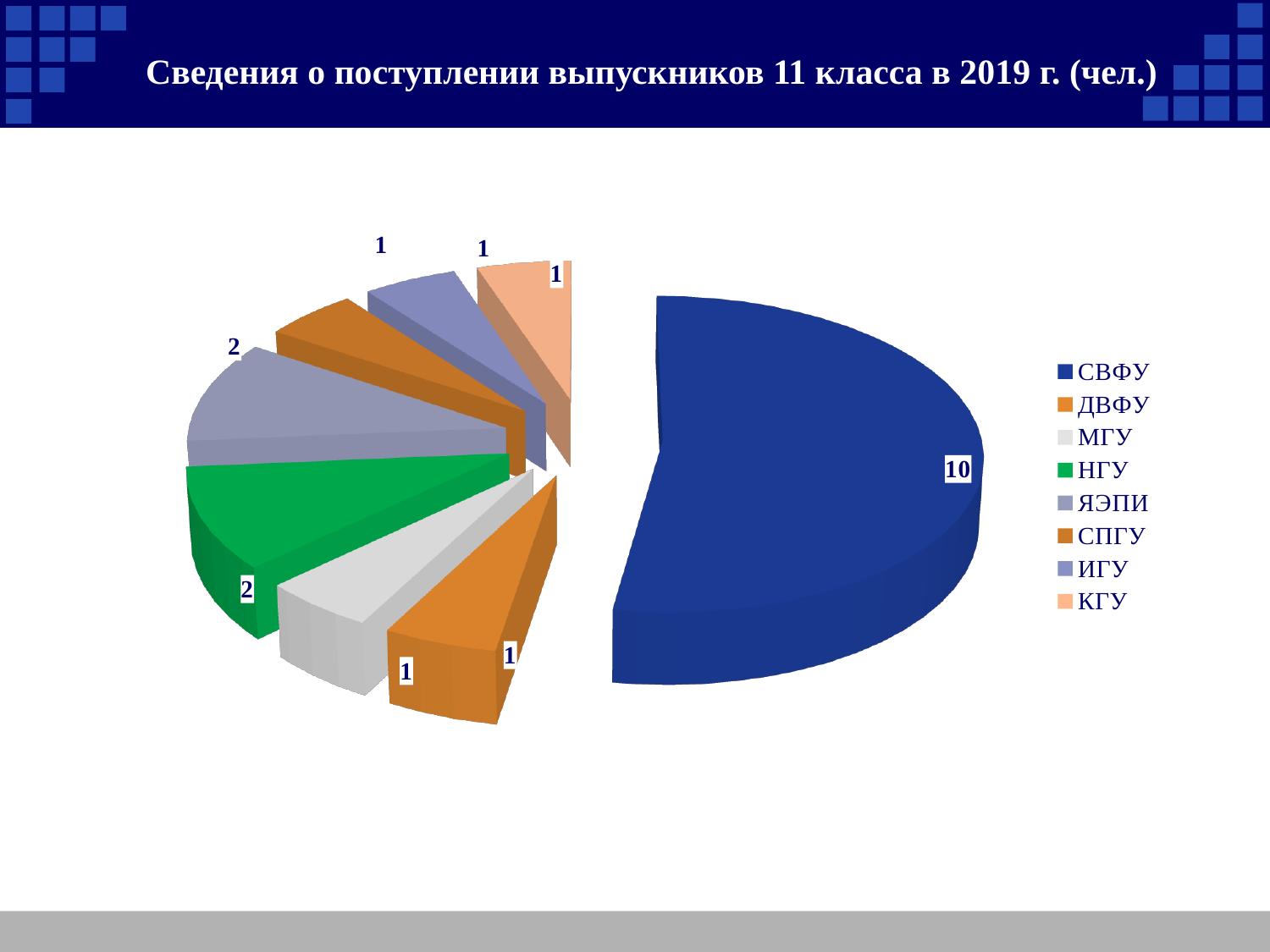
What is the value for НГУ? 2 What is the total of all the values shown in the pie chart? 19 What is the value for КГУ? 1 What is the difference between the values for СВФУ and НГУ? 8 Which legend entry is shown in green? НГУ Which university has the largest slice of the pie? СВФУ What is the title of the chart on the slide? Сведения о поступлении выпускников 11 класса в 2019 г. (чел.) What is the value for ЯЭПИ? 2 How many categories (universities) does the pie chart show? 8 What kind of chart is shown on the slide? pie chart How many people enrolled in СВФУ according to the chart? 10 Which is larger, the value for НГУ or the value for МГУ? НГУ